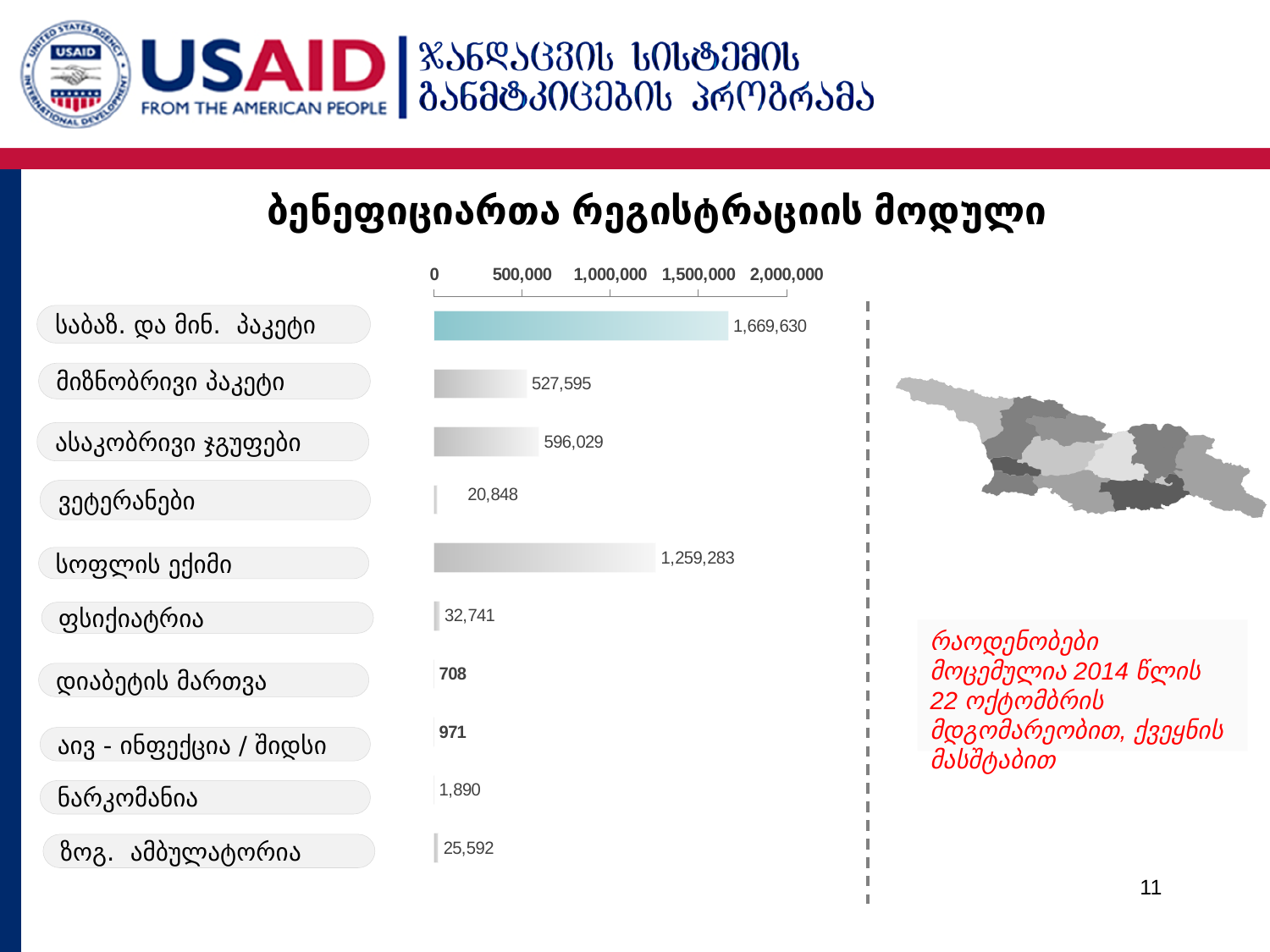
Is the value for სოფლის ექიმი greater or less than 1,000,000? greater What is the value for სოფლის ექიმი? 1,259,283 What kind of chart is shown on the slide? Bar chart Which category has the highest value? საბაზ. და მინ. პაკეტი What is the value for ვეტერანები? 20,848 What is the value for საბაზ. და მინ. პაკეტი? 1,669,630 Which category has the lowest value? დიაბეტის მართვა How many categories are shown in the chart? 10 What is the value for დიაბეტის მართვა? 708 What is the title of the slide above the chart? ბენეფიციართა რეგისტრაციის მოდული What is the difference between ასაკობრივი ჯგუფები and მიზნობრივი პაკეტი? 68,434 Which is larger, ფსიქიატრია or ზოგ. ამბულატორია? ფსიქიატრია